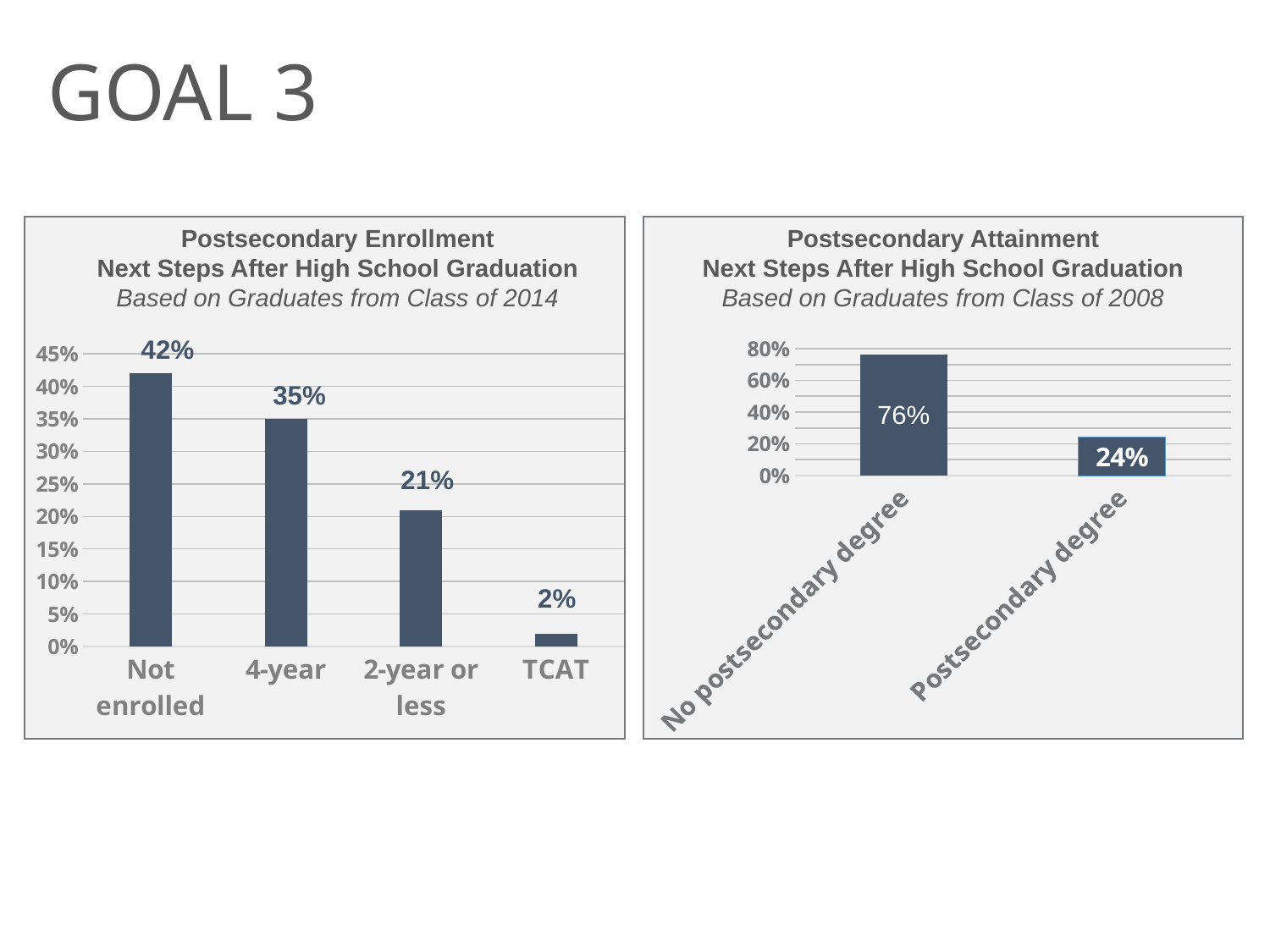
What kind of chart is the Postsecondary Attainment chart? bar chart In the Postsecondary Attainment chart, what is the value for No postsecondary degree? 76% In the Postsecondary Enrollment chart, what is the value for TCAT? 2% In the Postsecondary Enrollment chart, how many categories are shown? 4 In the Postsecondary Enrollment chart, which category has the highest value? Not enrolled In the Postsecondary Enrollment chart, which category has the lowest value? TCAT In the Postsecondary Attainment chart, what is the value for Postsecondary degree? 24% In the Postsecondary Enrollment chart, what is the difference between the 4-year and 2-year or less values? 14% In the Postsecondary Enrollment chart, do the values rise or fall from left to right? fall In the Postsecondary Attainment chart, which is larger: No postsecondary degree or Postsecondary degree? No postsecondary degree Which graduating class is the Postsecondary Attainment chart based on? Class of 2008 In the Postsecondary Enrollment chart, what is the value for Not enrolled? 42%